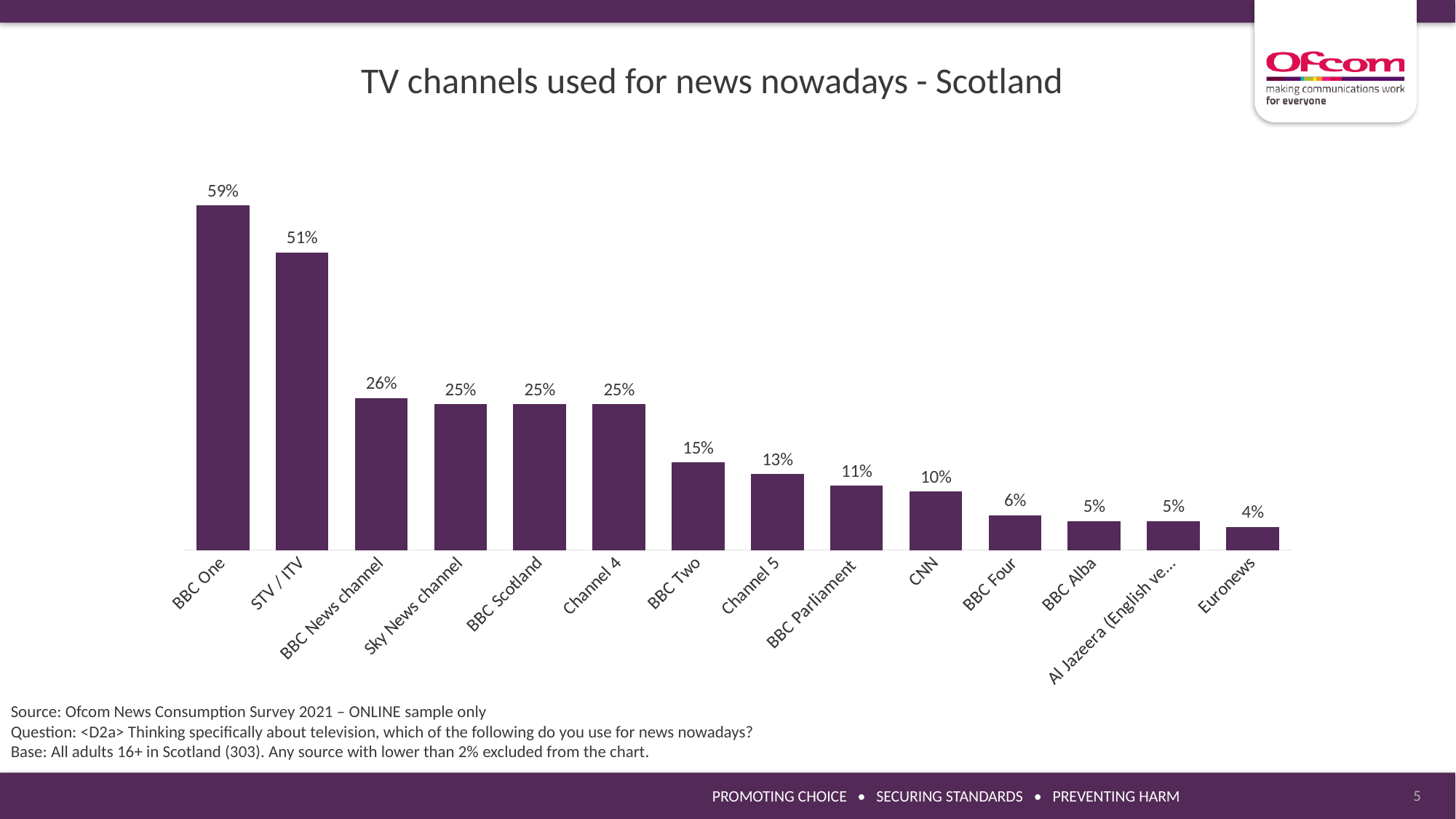
What type of chart is shown on the slide? Bar chart What is the title of the chart? TV channels used for news nowadays - Scotland Do the values rise or fall moving from left to right along the x axis? Fall How many TV channels are shown on the chart? 14 What percentage is shown for BBC Parliament? 11% Which TV channel has the highest value on the chart? BBC One Which TV channel has the lowest value on the chart? Euronews What is the difference between the values for BBC One and STV / ITV? 8 percentage points Which has a higher value, BBC Two or Channel 5? BBC Two What is the difference between the values for BBC News channel and CNN? 16 percentage points What percentage of respondents use BBC One for news nowadays? 59% What is the value shown for STV / ITV? 51%